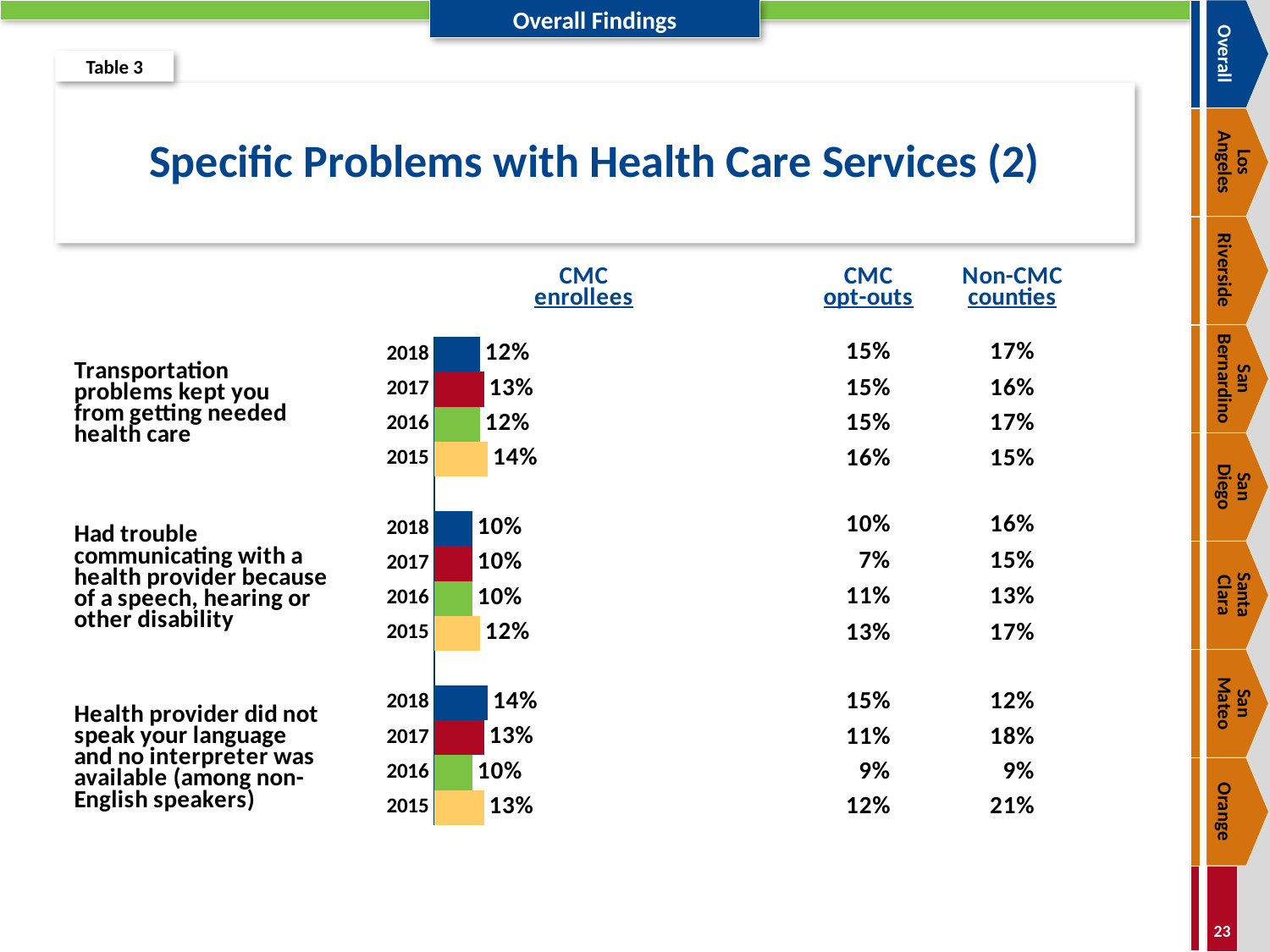
What is the difference between the 2015 and 2018 CMC enrollees values for "Transportation problems kept you from getting needed health care"? 2% What colour is the bar for 2018 in the CMC enrollees chart? blue Among the CMC enrollees bars for "Health provider did not speak your language and no interpreter was available", which year has the highest value? 2018 What is the CMC enrollees value for 2018 for "Transportation problems kept you from getting needed health care"? 12% Among the CMC enrollees bars for "Health provider did not speak your language and no interpreter was available", which year has the lowest value? 2016 What is the CMC enrollees value for 2015 for "Had trouble communicating with a health provider because of a speech, hearing or other disability"? 12% What kind of chart is used to show the CMC enrollees values? bar chart What is the difference between the 2018 and 2016 CMC enrollees values for "Health provider did not speak your language and no interpreter was available"? 4% What is the CMC enrollees value for 2016 for "Health provider did not speak your language and no interpreter was available"? 10% Among the CMC enrollees bars for "Transportation problems kept you from getting needed health care", which year has the highest value? 2015 For CMC enrollees, is the 2015 value for "Had trouble communicating with a health provider because of a speech, hearing or other disability" larger or smaller than the 2018 value? larger How many years are shown as bars for each problem in the CMC enrollees chart? 4